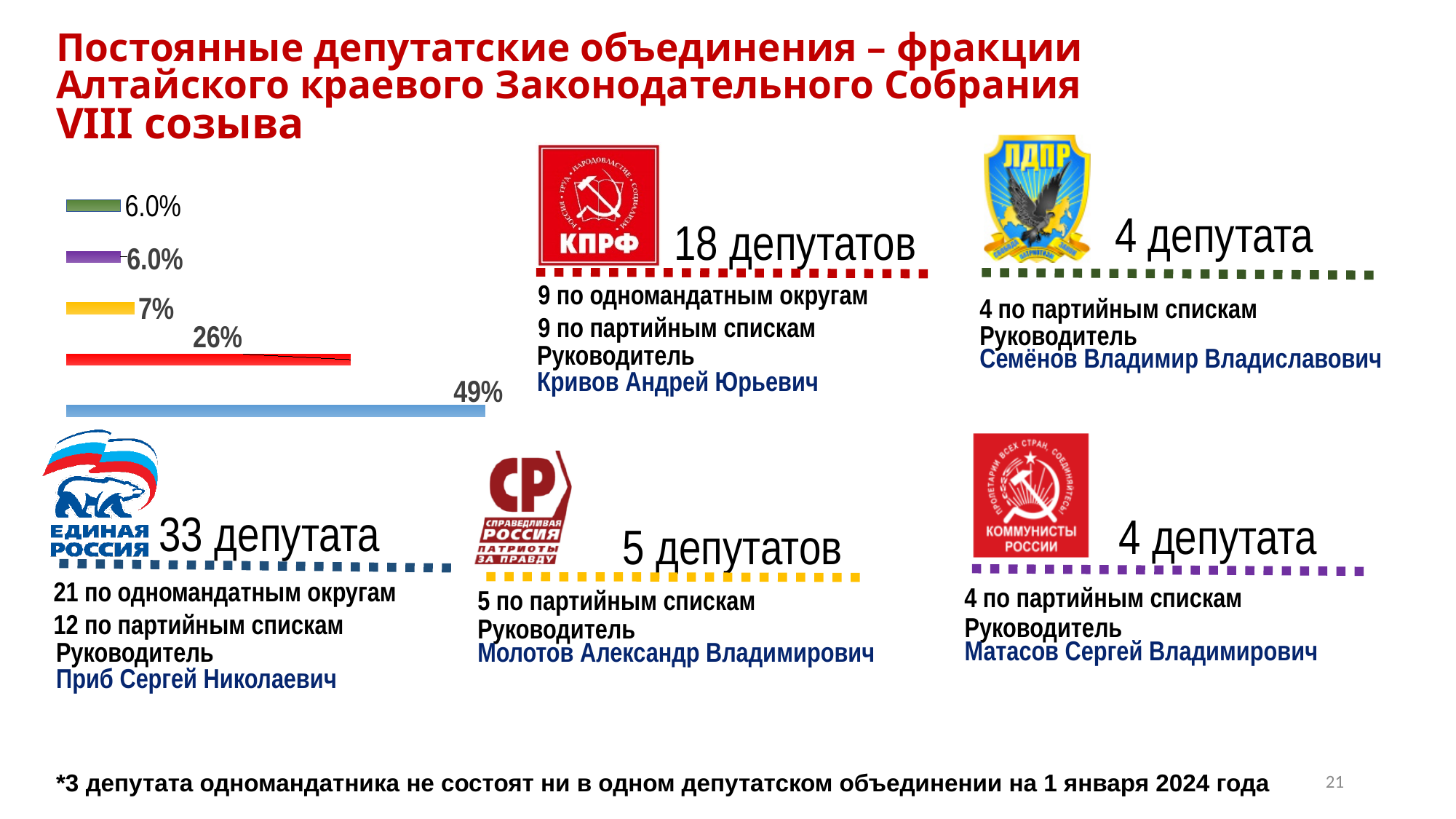
What is the value labelled on the red bar of the chart? 26% What is the difference between the blue bar (49%) and the red bar (26%) in the chart? 23% What is the value labelled on the purple bar of the chart? 6.0% Do the bar values in the chart increase or decrease going from the top bar to the bottom bar? increase How many bars does the chart on the left of the slide contain? 5 What is the value labelled on the topmost (green) bar of the chart? 6.0% What is the value labelled on the longest bar of the chart? 49% What is the value labelled on the yellow bar of the chart? 7% What is the smallest value labelled on the chart? 6.0% What kind of chart is shown on the left of the slide? bar chart What colour is the longest bar in the chart? blue Which bar has the larger value in the chart, the red bar or the yellow bar? the red bar